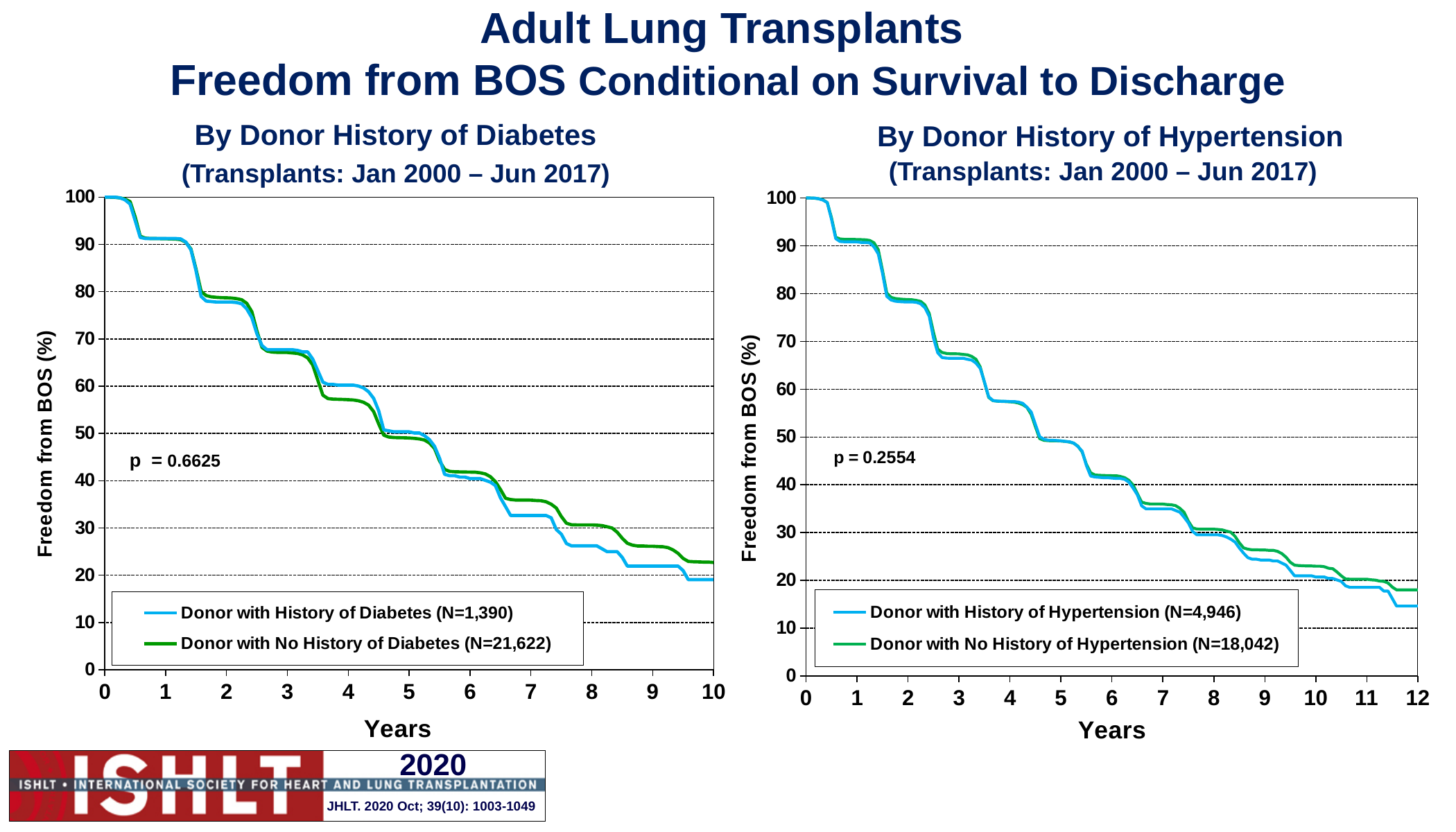
In the 'By Donor History of Hypertension' chart, what is the N for donors with a history of hypertension according to the legend? N=4,946 In the 'By Donor History of Hypertension' chart, is the value for Donor with History of Hypertension at 3 years greater or less than 60? greater In the 'By Donor History of Diabetes' chart, is the value for Donor with History of Diabetes at 8 years greater or less than 30? less What kind of chart is the 'By Donor History of Diabetes' chart? line chart In the 'By Donor History of Diabetes' chart, what is the p-value shown? p = 0.6625 In the 'By Donor History of Diabetes' chart, do the curves rise or fall as years increase? fall In the 'By Donor History of Hypertension' chart, at 12 years, which series has the higher freedom from BOS? Donor with No History of Hypertension In the 'By Donor History of Hypertension' chart, what is the p-value shown? p = 0.2554 In the 'By Donor History of Diabetes' chart, at 10 years, which series has the higher freedom from BOS? Donor with No History of Diabetes How many series does the legend of the 'By Donor History of Hypertension' chart list? 2 In the 'By Donor History of Diabetes' chart, what is the N for donors with no history of diabetes according to the legend? N=21,622 In the 'By Donor History of Diabetes' chart, is the value for Donor with No History of Diabetes at 4 years greater or less than 60? less